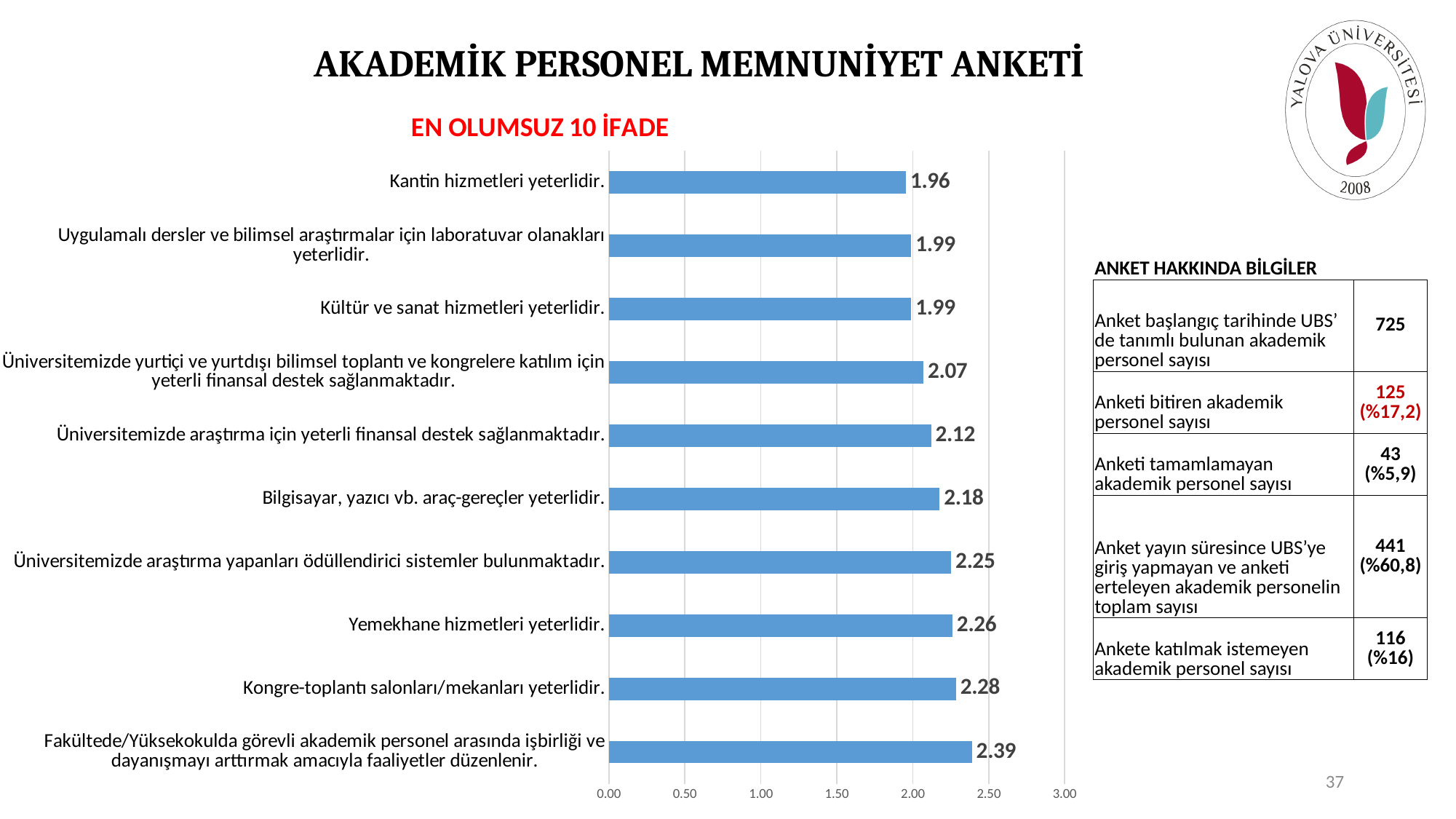
What is the difference between the values for "Kongre-toplantı salonları/mekanları yeterlidir." and "Kantin hizmetleri yeterlidir."? 0.32 Which is larger: the value for "Üniversitemizde araştırma için yeterli finansal destek sağlanmaktadır." or the value for "Üniversitemizde araştırma yapanları ödüllendirici sistemler bulunmaktadır."? Üniversitemizde araştırma yapanları ödüllendirici sistemler bulunmaktadır. What is the value for "Kantin hizmetleri yeterlidir."? 1.96 Which category has the highest value? Fakültede/Yüksekokulda görevli akademik personel arasında işbirliği ve dayanışmayı arttırmak amacıyla faaliyetler düzenlenir. How many categories are shown in the chart? 10 What is the value for "Bilgisayar, yazıcı vb. araç-gereçler yeterlidir."? 2.18 What is the title of the chart? EN OLUMSUZ 10 İFADE Is the value for "Kültür ve sanat hizmetleri yeterlidir." greater or less than 2.50? less What is the maximum value shown on the chart's value axis? 3.00 What kind of chart is shown on the slide? bar chart What is the value for "Yemekhane hizmetleri yeterlidir."? 2.26 Which category has the lowest value? Kantin hizmetleri yeterlidir.